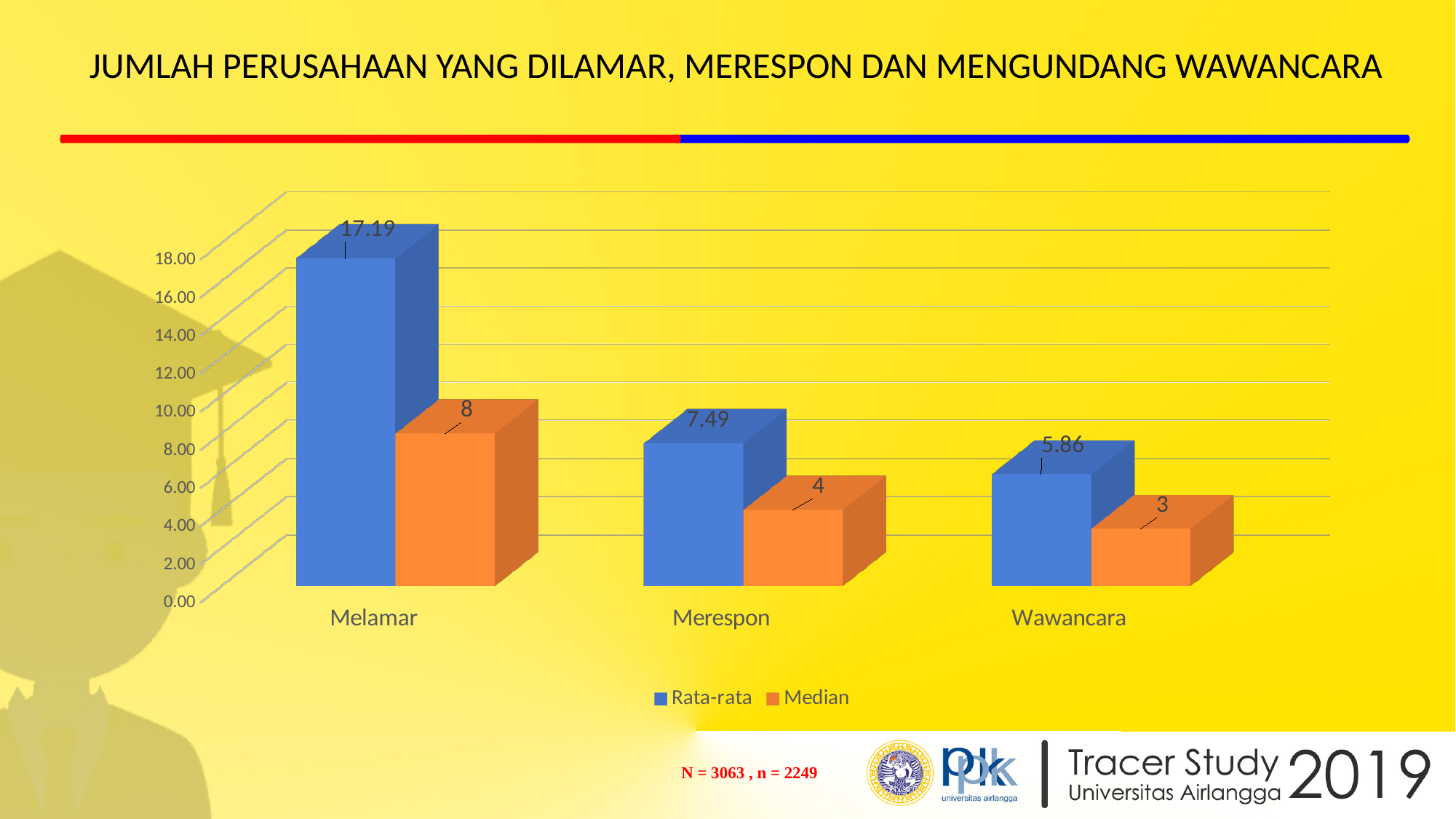
How many series does the legend list? 2 Which category has the highest Rata-rata value? Melamar What is the Rata-rata value for Melamar? 17.19 Which category has the lowest Median value? Wawancara How many categories are shown on the x axis? 3 What is the Median value for Merespon? 4 What kind of chart is shown on the slide? Bar chart What is the Rata-rata value for Wawancara? 5.86 Do the Rata-rata values rise or fall from Melamar to Wawancara? Fall What is the Median value for Melamar? 8 Which is larger, the Median value for Merespon or the Median value for Wawancara? Merespon What is the difference between the Rata-rata values for Melamar and Merespon? 9.70